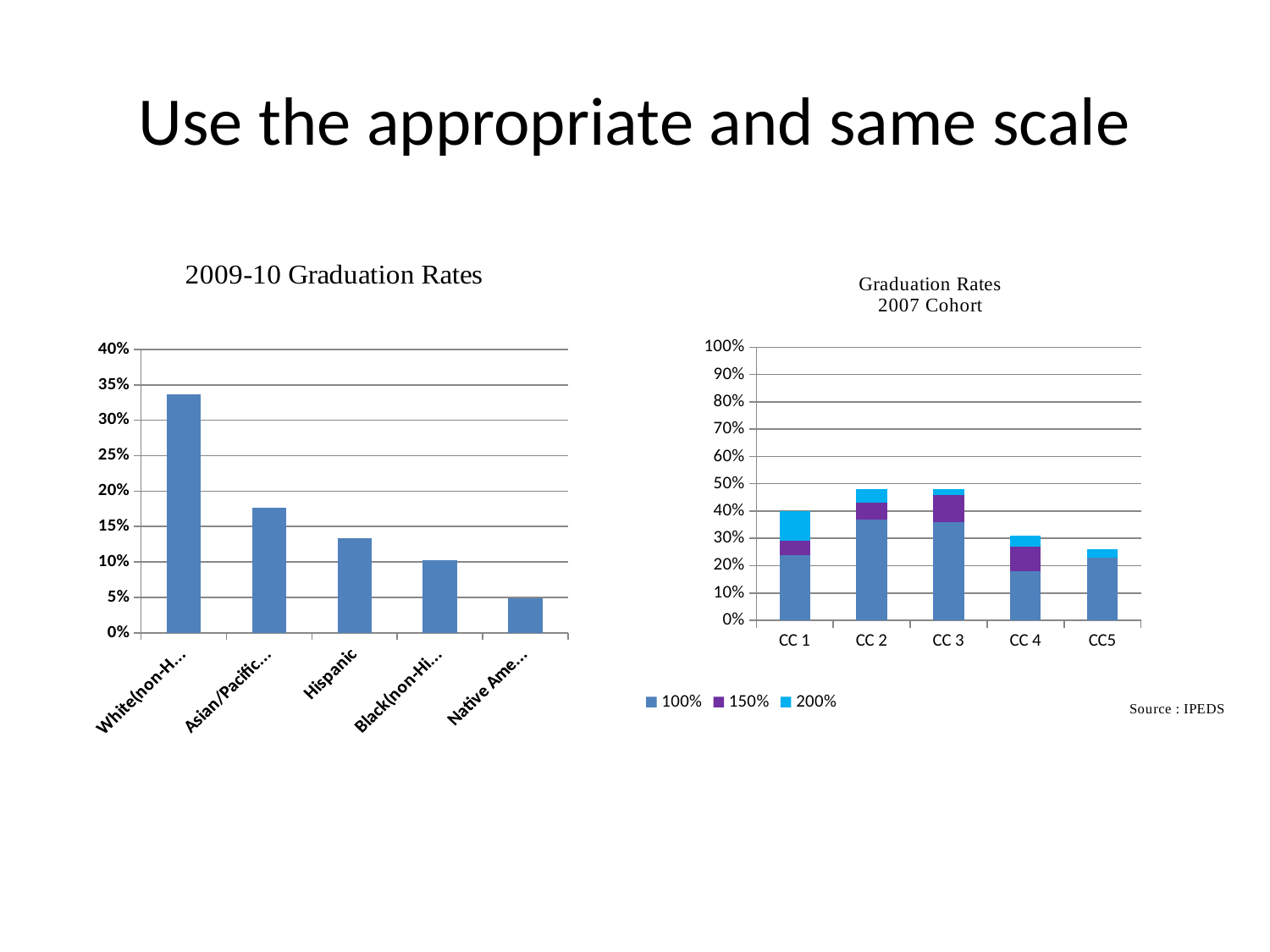
How many categories are shown in the left chart, "2009-10 Graduation Rates"? 5 In the left chart, "2009-10 Graduation Rates", what is the highest value shown on the vertical axis? 40% How many colleges (categories) are shown in the right chart, "Graduation Rates 2007 Cohort"? 5 In the left chart, "2009-10 Graduation Rates", is the value for Hispanic greater or less than 10%? greater In the left chart, "2009-10 Graduation Rates", which category has the highest graduation rate? White(non-H... In the right chart, "Graduation Rates 2007 Cohort", which is larger: the 100% series value for CC 2 or for CC 4? CC 2 What kind of chart is the left chart titled "2009-10 Graduation Rates"? Bar chart In the left chart, "2009-10 Graduation Rates", do the values rise or fall from left to right across the categories? Fall In the right chart, "Graduation Rates 2007 Cohort", is the total stacked bar for CC5 greater or less than 30%? less How many series does the legend list in the right chart, "Graduation Rates 2007 Cohort"? 3 In the right chart, "Graduation Rates 2007 Cohort", which college has the lowest total stacked bar? CC5 In the left chart, "2009-10 Graduation Rates", which category has the lowest graduation rate? Native Ame...